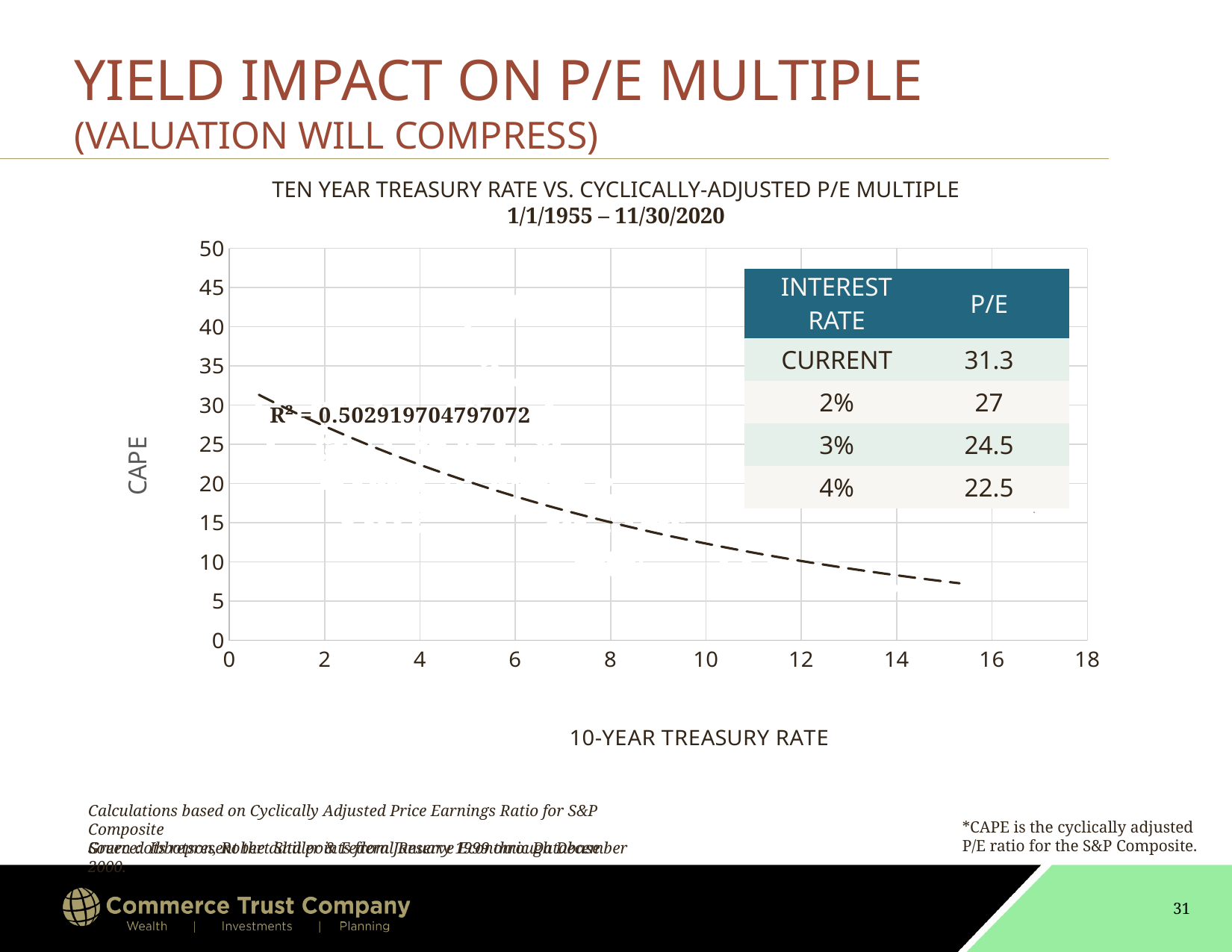
In the table on the chart, what is the difference between the P/E at 2% and the P/E at 4%? 4.5 Is the trend line's CAPE value at a 10-year Treasury rate of 2 greater or less than 25? greater In the table on the chart, which interest rate row has the lowest P/E? 4% Is the trend line's CAPE value at a 10-year Treasury rate of 4 greater or less than 20? greater In the table on the chart, what is the P/E at a 3% interest rate? 24.5 Is the trend line's CAPE value at a 10-year Treasury rate of 14 greater or less than 10? less Does the dashed trend line rise or fall as the 10-year Treasury rate increases? Fall What is the title of the chart? TEN YEAR TREASURY RATE VS. CYCLICALLY-ADJUSTED P/E MULTIPLE What date range does the chart subtitle give? 1/1/1955 – 11/30/2020 What is the R² value printed on the chart? 0.502919704797072 In the table on the chart, what is the P/E for the CURRENT interest rate? 31.3 What kind of chart is shown on the slide? Scatter chart with a trend line